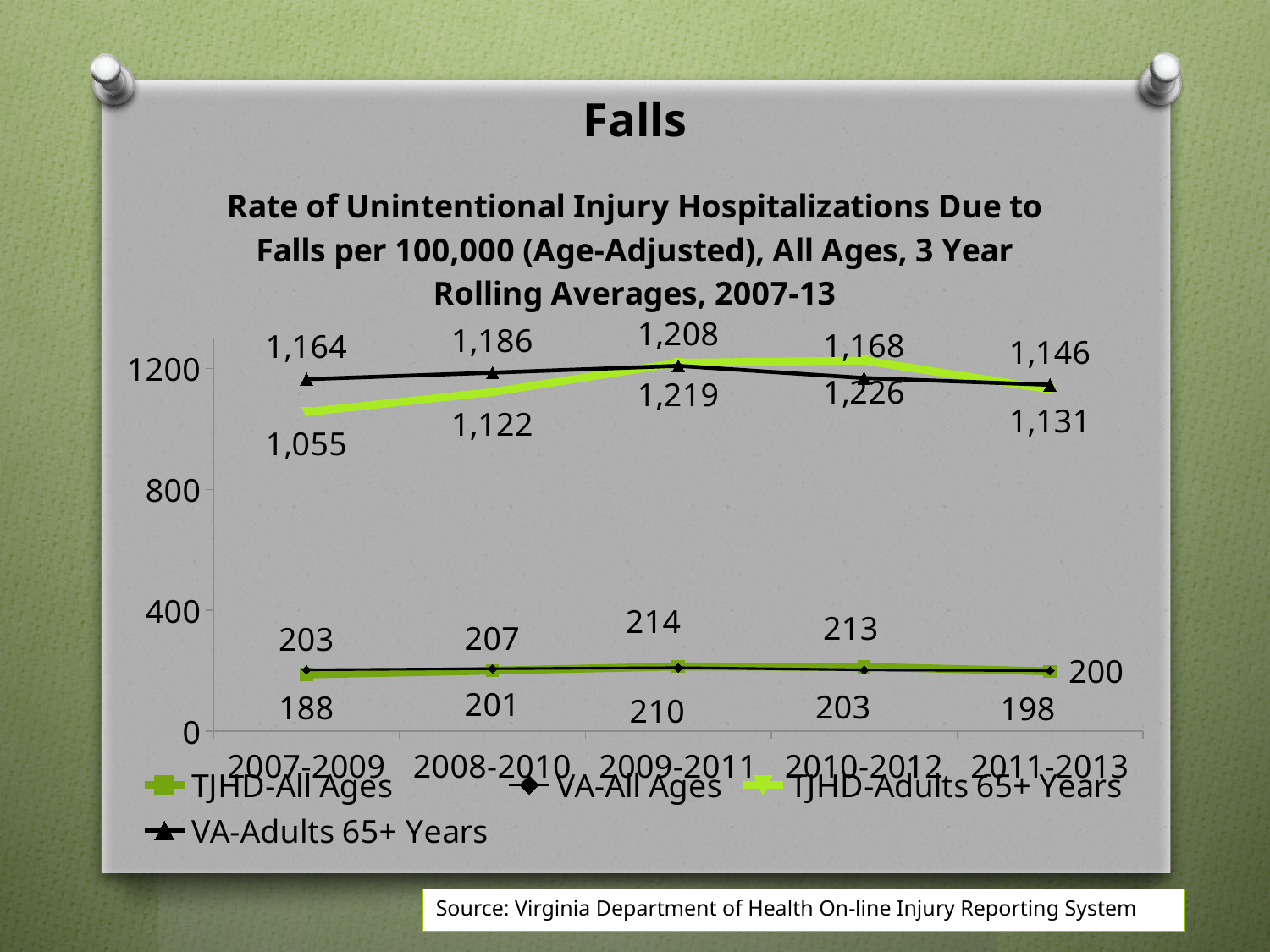
What is the value for VA-All Ages in 2009-2011? 210 What is the value for TJHD-All Ages in 2011-2013? 198 How many time periods are plotted along the x axis? 5 What is the difference between VA-Adults 65+ Years and TJHD-Adults 65+ Years in 2007-2009? 109 How many series does the legend list? 4 What is the value for VA-Adults 65+ Years in 2009-2011? 1,208 In which period is the TJHD-Adults 65+ Years rate highest? 2010-2012 What is the value for TJHD-Adults 65+ Years in 2007-2009? 1,055 In 2010-2012, which is larger: TJHD-Adults 65+ Years or VA-Adults 65+ Years? TJHD-Adults 65+ Years What kind of chart is shown on the slide? line chart Does the TJHD-Adults 65+ Years rate rise or fall from 2007-2009 to 2010-2012? rise In which period is the VA-All Ages rate lowest? 2011-2013